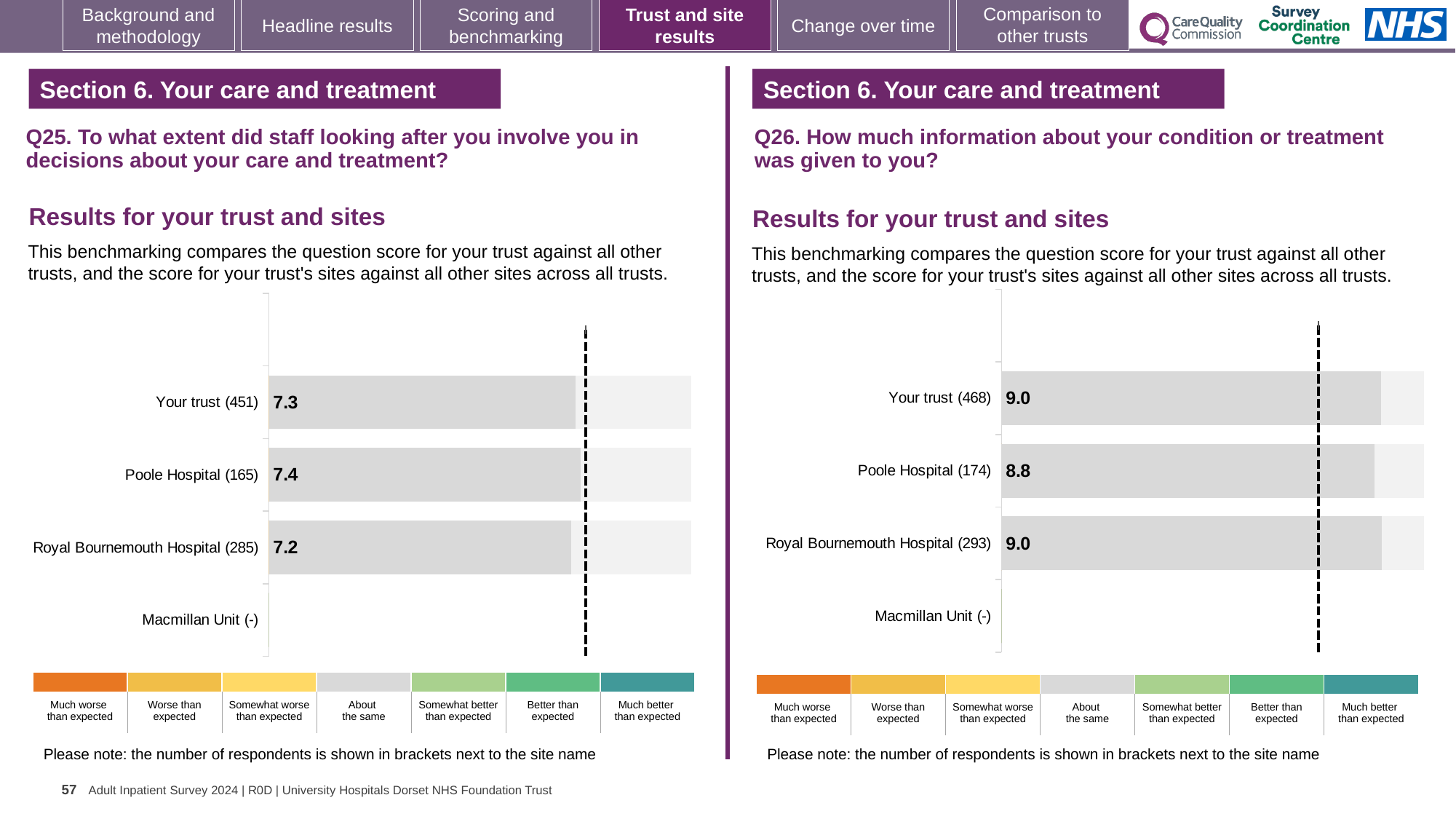
On the Q26 chart (right), what is the difference between the Royal Bournemouth Hospital score and the Poole Hospital score? 0.2 On the Q26 chart (right), what is the score for Your trust? 9.0 On the Q25 chart (left), what is the difference between the Poole Hospital score and the Royal Bournemouth Hospital score? 0.2 On the Q25 chart (left), what is the score for Poole Hospital? 7.4 On the Q25 chart (left), how many respondents are shown in brackets for Royal Bournemouth Hospital? 285 On the Q26 chart (right), which site has the lowest score? Poole Hospital On the Q26 chart (right), is the score for Your trust larger or smaller than the score for Poole Hospital? larger On the Q26 chart (right), what is the score for Poole Hospital? 8.8 On the Q25 chart (left), which site has the highest score? Poole Hospital On the Q25 chart (left), what is the score for Your trust? 7.3 On the Q25 chart (left), what is the score for Royal Bournemouth Hospital? 7.2 What kind of chart is used on the Q25 chart (left)? bar chart